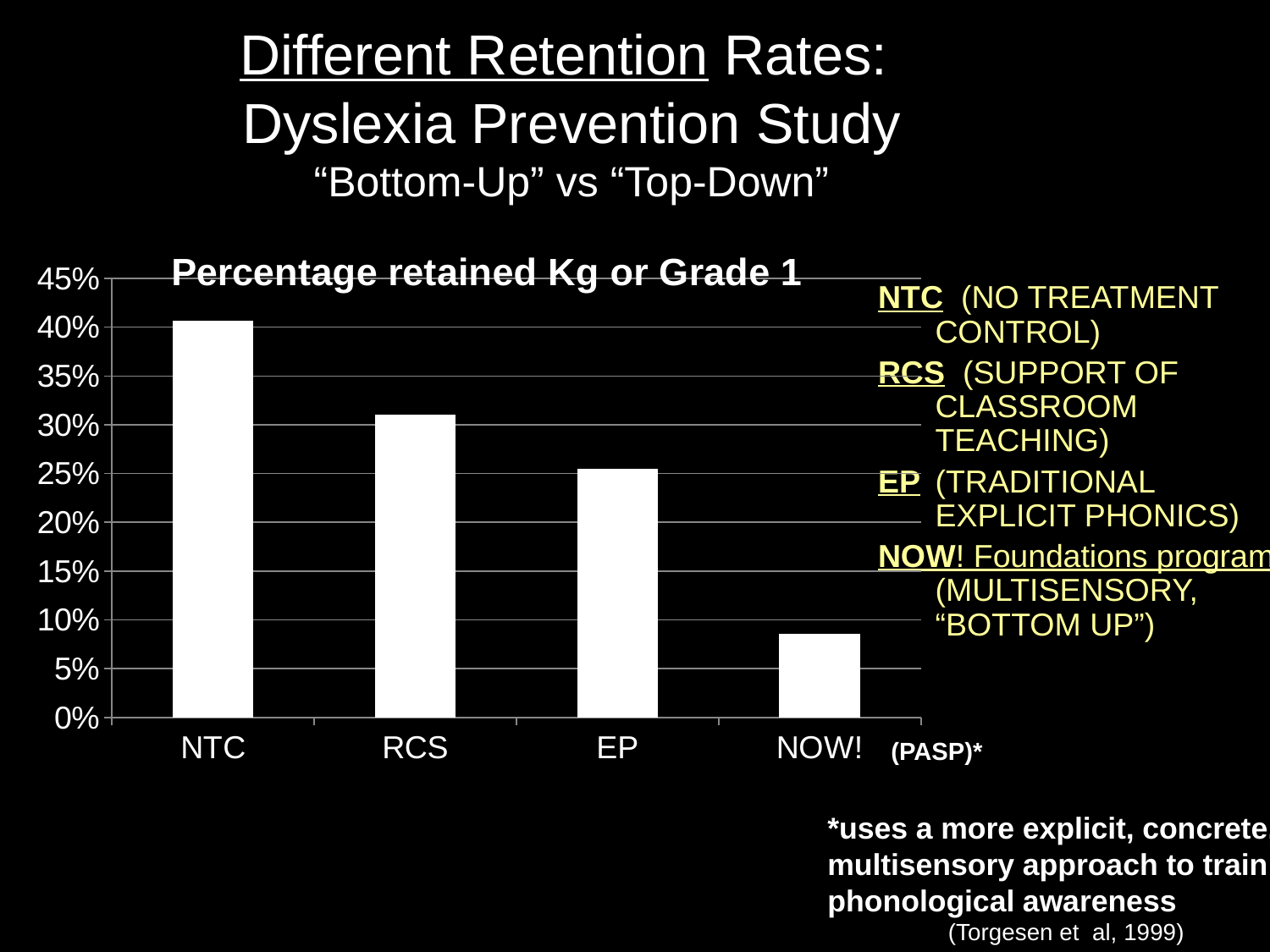
Is the value for NOW! greater or less than 10%? less Which category has the highest percentage retained? NTC Is the value for NTC greater or less than 35%? greater Which is larger, the value for RCS or the value for EP? RCS What kind of chart is shown on the slide? bar chart Is the value for EP greater or less than 30%? less What is the maximum value shown on the y axis of the chart? 45% What is the title of the chart? Percentage retained Kg or Grade 1 Which category has the lowest percentage retained? NOW! How many categories are shown on the x axis of the chart? 4 Do the values rise or fall moving from NTC to NOW! along the x axis? fall